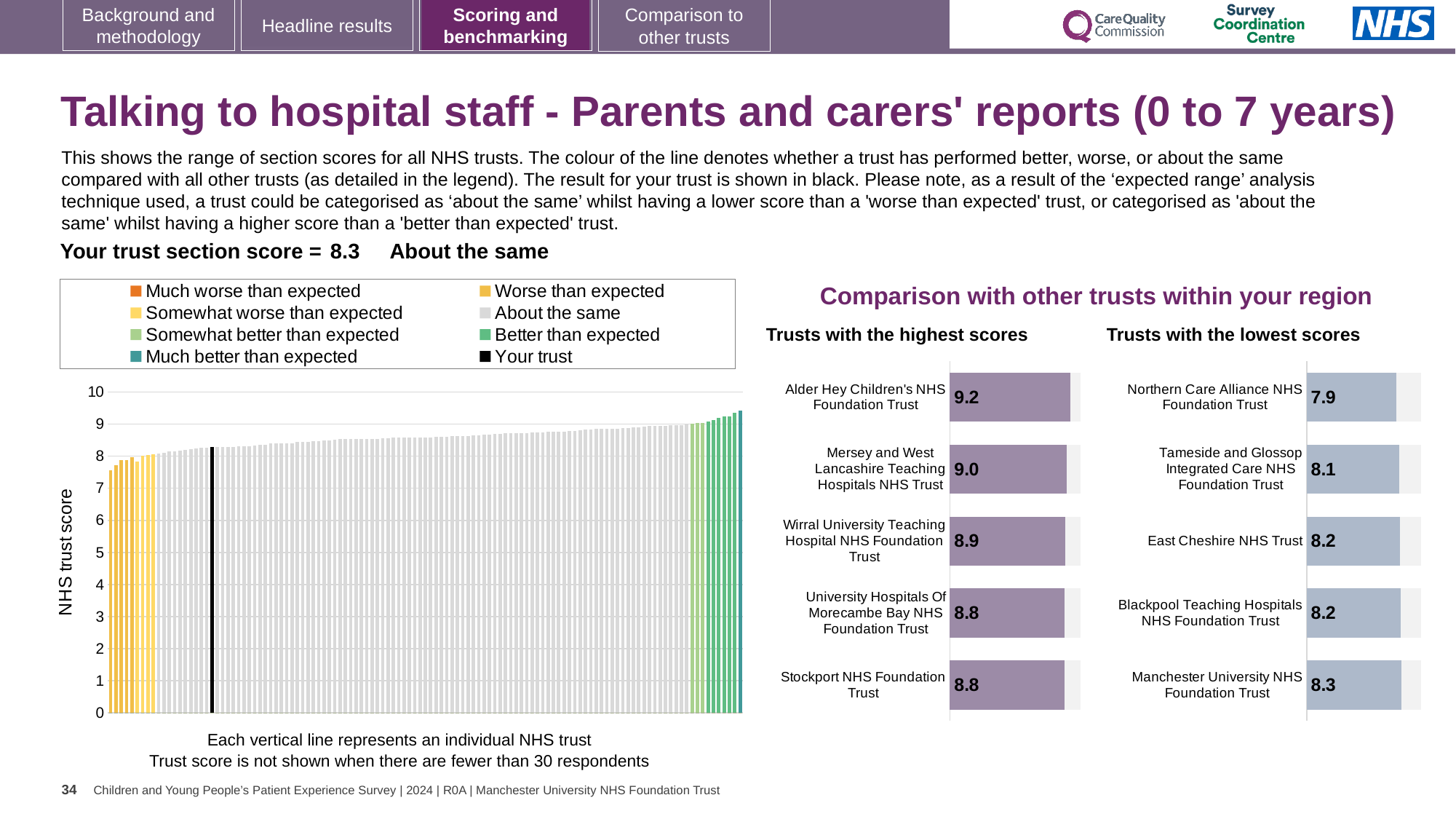
In the 'Trusts with the highest scores' chart, what is the score for Wirral University Teaching Hospital NHS Foundation Trust? 8.9 How many trusts are shown in the 'Trusts with the highest scores' chart? 5 How many entries does the legend of the main NHS trust score chart list? 8 In the 'Trusts with the lowest scores' chart, what is the score for Manchester University NHS Foundation Trust? 8.3 In the 'Trusts with the highest scores' chart, which trust has the highest score? Alder Hey Children's NHS Foundation Trust In the 'Trusts with the lowest scores' chart, which trust has the lowest score? Northern Care Alliance NHS Foundation Trust In the main NHS trust score chart, do the trust scores rise or fall from left to right? rise In the 'Trusts with the highest scores' chart, what is the difference between the scores of Alder Hey Children's NHS Foundation Trust and Stockport NHS Foundation Trust? 0.4 In the 'Trusts with the lowest scores' chart, which has the higher score: Tameside and Glossop Integrated Care NHS Foundation Trust or East Cheshire NHS Trust? East Cheshire NHS Trust What kind of chart is the main chart showing the NHS trust scores for all trusts? bar chart In the 'Trusts with the highest scores' chart, what is the score for Alder Hey Children's NHS Foundation Trust? 9.2 In the 'Trusts with the lowest scores' chart, what is the score for Northern Care Alliance NHS Foundation Trust? 7.9